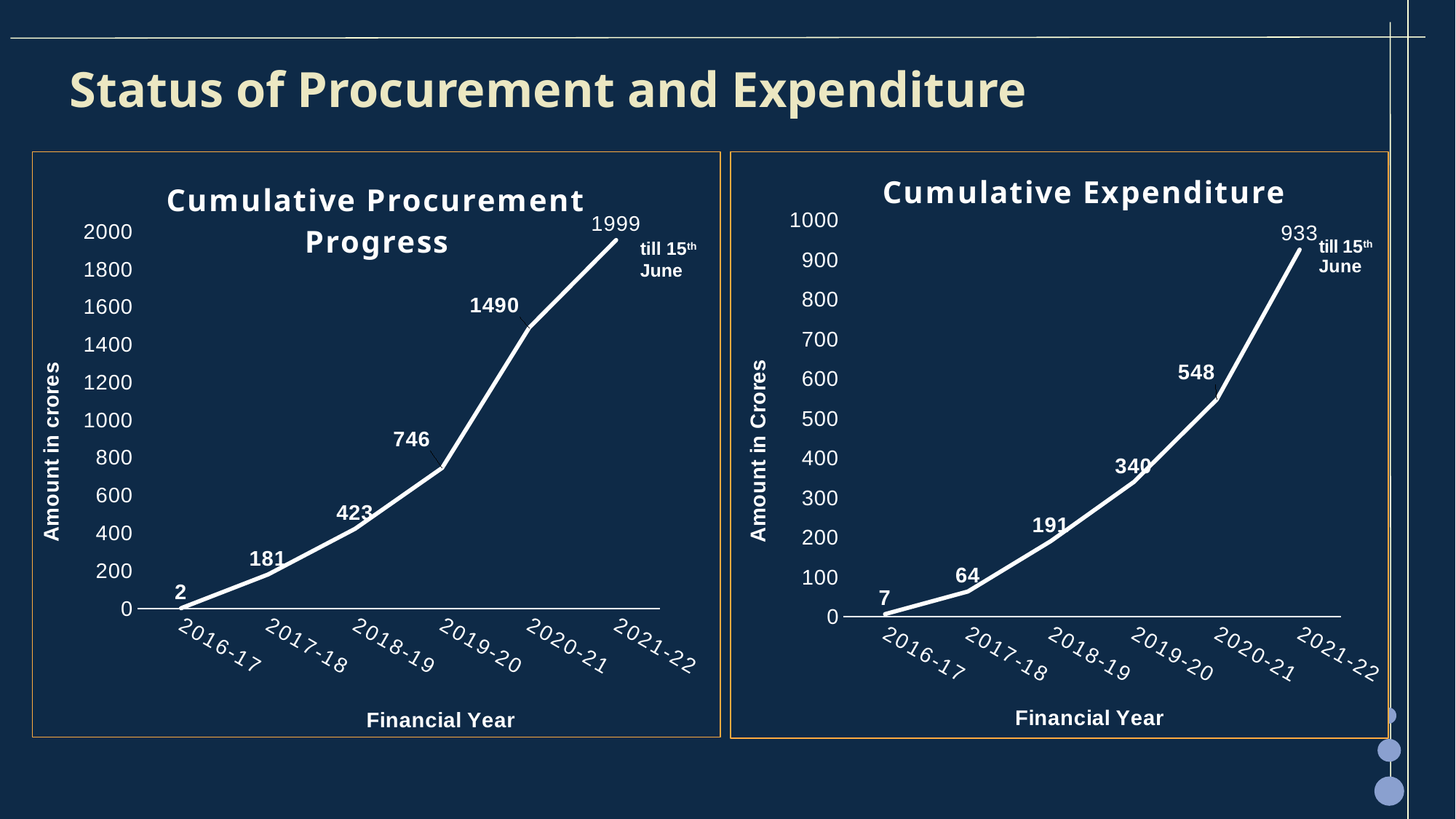
In the Cumulative Expenditure chart, which financial year has the highest value? 2021-22 In the Cumulative Expenditure chart, which is larger, the value for 2018-19 or the value for 2019-20? 2019-20 In the Cumulative Procurement Progress chart, what is the value for 2021-22? 1999 In the Cumulative Expenditure chart, what is the value for 2019-20? 340 In the Cumulative Procurement Progress chart, what is the difference between the values for 2020-21 and 2019-20? 744 How many financial years are plotted in the Cumulative Procurement Progress chart? 6 In the Cumulative Procurement Progress chart, what is the value for 2018-19? 423 In the Cumulative Procurement Progress chart, do the values rise or fall from 2016-17 to 2021-22? Rise In the Cumulative Procurement Progress chart, which financial year has the lowest value? 2016-17 In the Cumulative Expenditure chart, what is the difference between the values for 2020-21 and 2019-20? 208 What kind of chart is the Cumulative Expenditure chart? Line chart In the Cumulative Expenditure chart, what is the value for 2017-18? 64